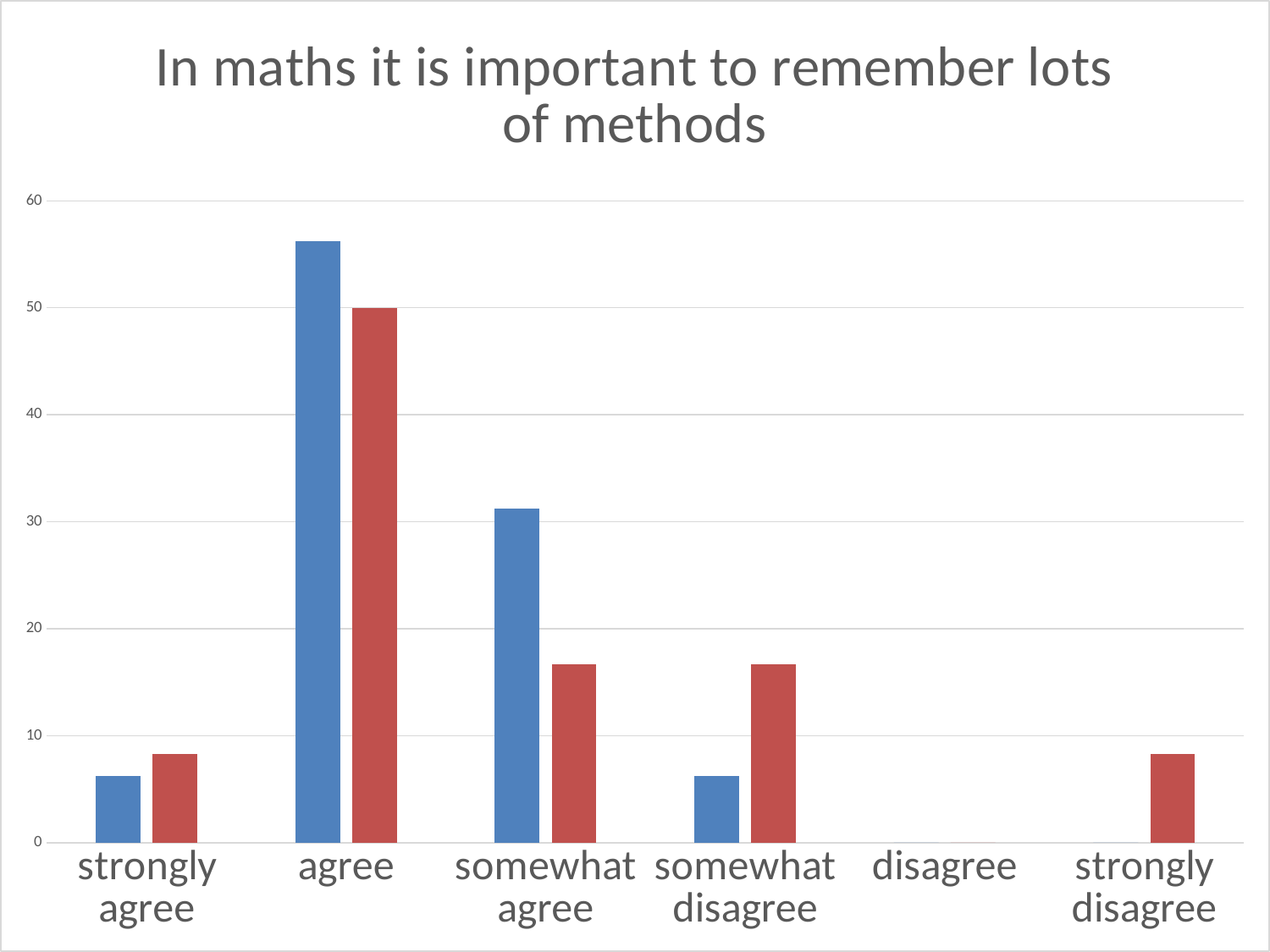
For 'somewhat disagree', which bar is taller, the blue one or the red one? red Which category shows no bar for either series? disagree Is the blue bar for 'somewhat agree' greater or less than 40? less Is the red bar for 'strongly disagree' greater or less than 10? less How many response categories are shown on the x axis? 6 Which category has the highest red bar? agree For 'agree', which bar is taller, the blue one or the red one? blue What is the title of the chart? In maths it is important to remember lots of methods For 'somewhat agree', which bar is taller, the blue one or the red one? blue What kind of chart is shown on the slide? bar chart Is the blue bar for 'agree' greater or less than 50? greater Which category has the highest blue bar? agree